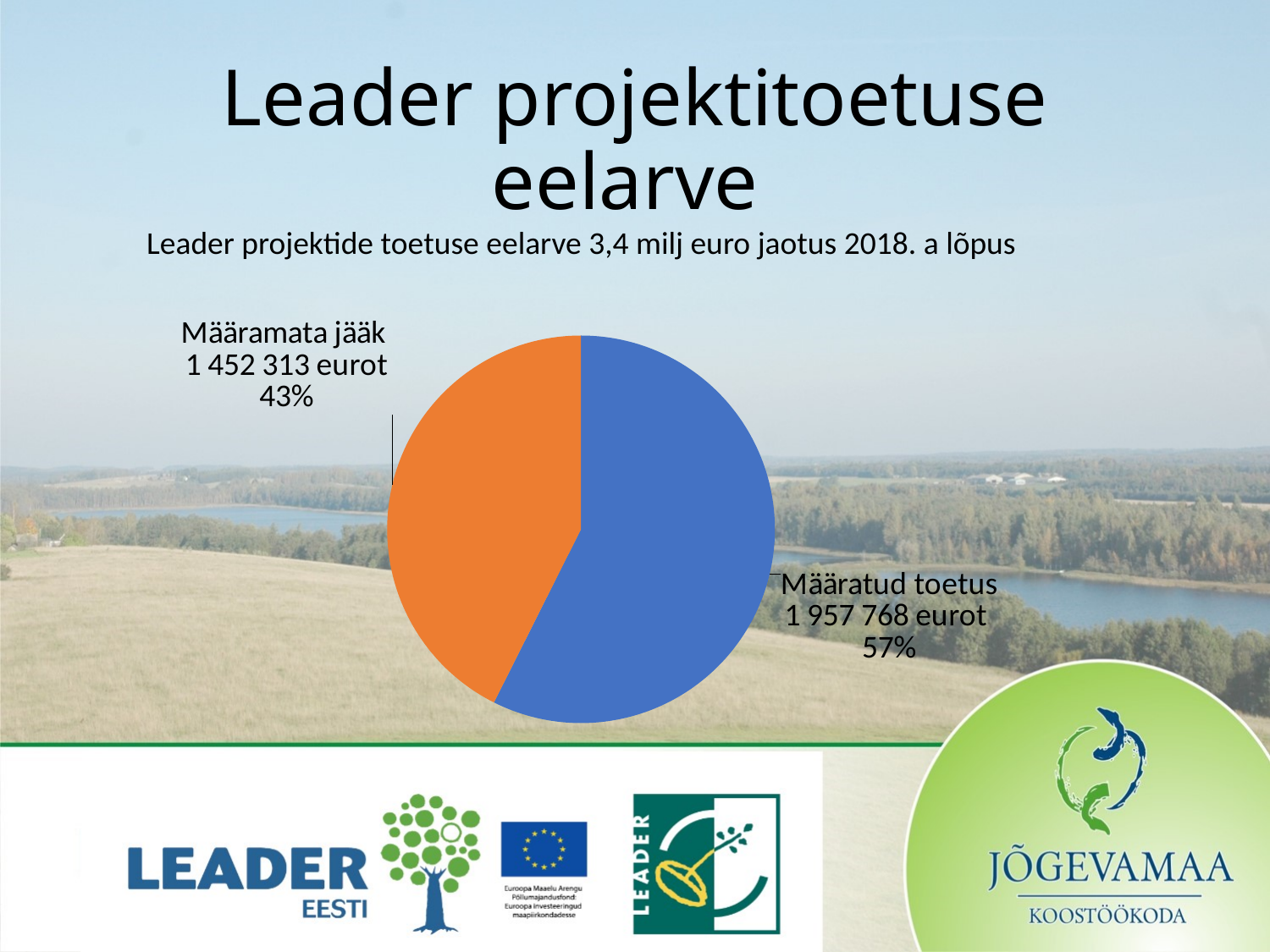
What kind of chart is shown on the slide? pie chart What is the value for Määramata jääk? 1 452 313 eurot What is the value for Määratud toetus? 1 957 768 eurot Which slice is the largest? Määratud toetus How many slices does the pie chart have? 2 What colour is the Määramata jääk slice? orange What share of the pie does Määramata jääk represent? 43% Which is larger, Määratud toetus or Määramata jääk? Määratud toetus What is the title of the chart? Leader projektide toetuse eelarve 3,4 milj euro jaotus 2018. a lõpus What is the difference in euros between Määratud toetus and Määramata jääk? 505 455 eurot Which slice is the smallest? Määramata jääk What share of the pie does Määratud toetus represent? 57%